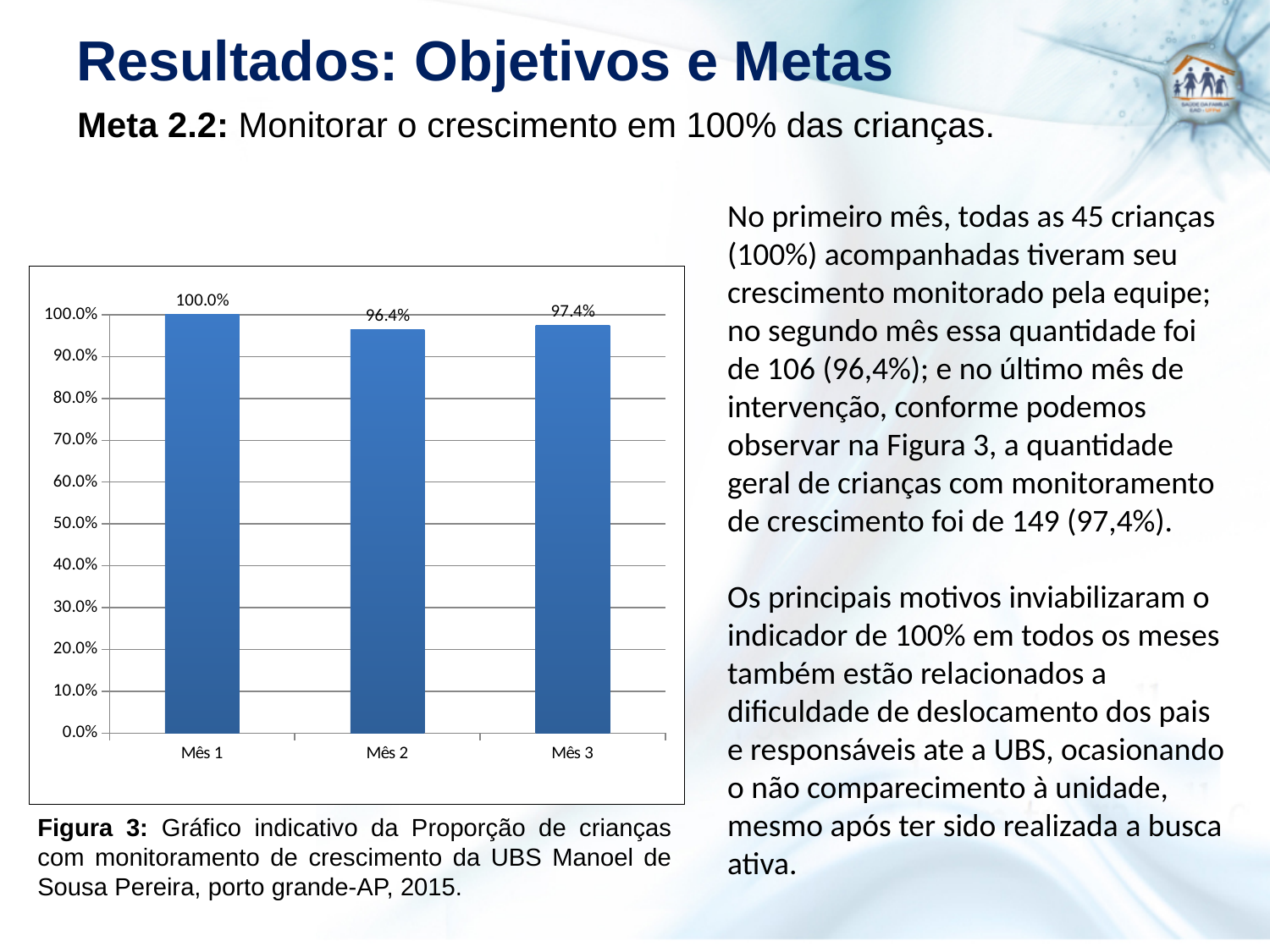
What is the difference between the values for Mês 3 and Mês 2? 1.0% Which is larger, the value for Mês 2 or the value for Mês 3? Mês 3 What is the value for Mês 1? 100.0% What is the value for Mês 3? 97.4% How many categories are shown on the x axis? 3 Is the value for Mês 2 greater or less than 90.0%? greater What is the value for Mês 2? 96.4% Which month has the highest value? Mês 1 What kind of chart is shown on the slide? bar chart What is the difference between the values for Mês 1 and Mês 2? 3.6% What is the figure number given in the caption below the chart? Figura 3 Which month has the lowest value? Mês 2